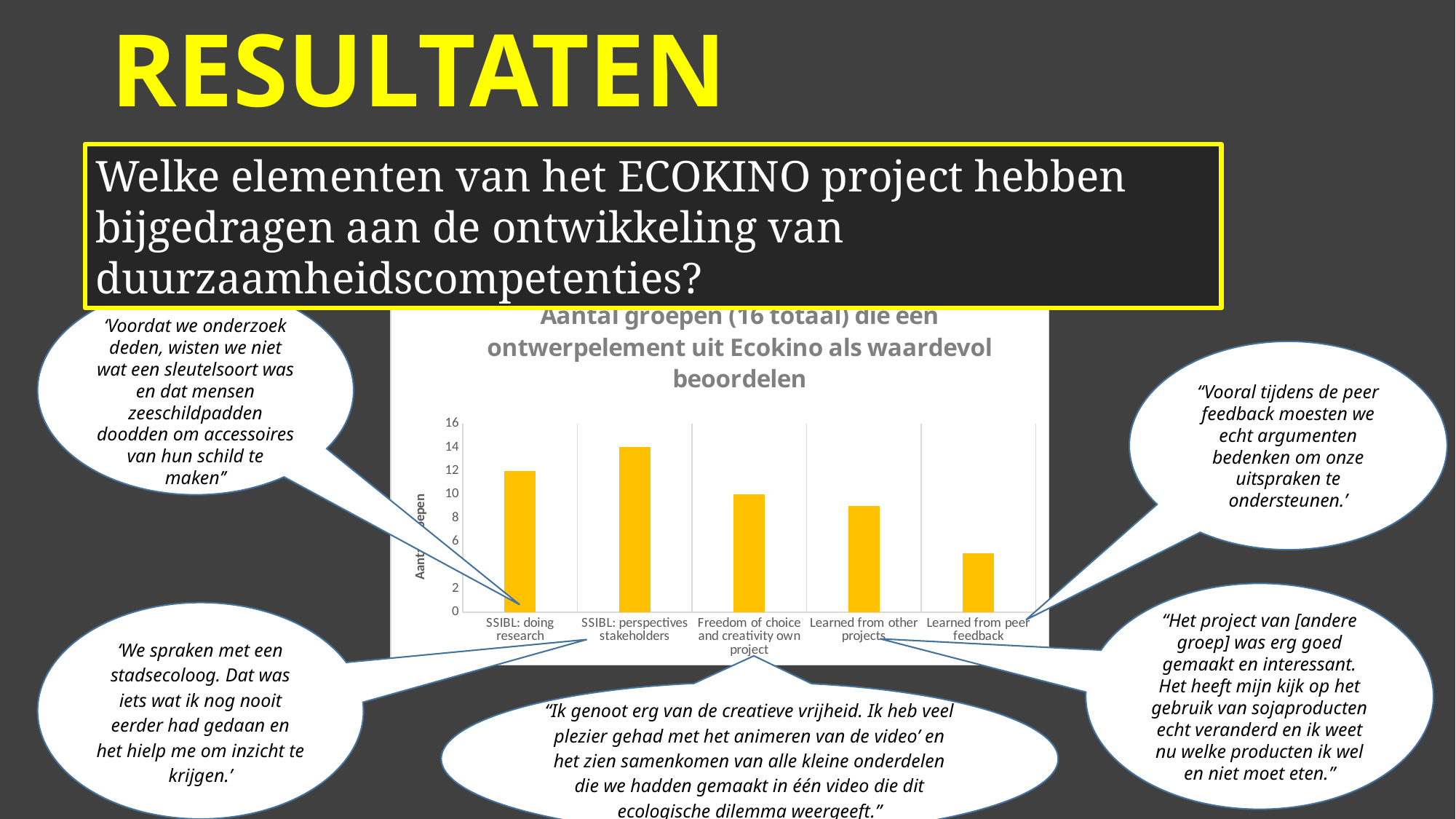
What kind of chart is shown on the slide? bar chart Which is larger: the value for SSIBL: doing research or the value for Learned from other projects? SSIBL: doing research Do the bar values generally rise or fall from left to right across the chart? fall How many categories are shown on the x axis of the chart? 5 What is the value for SSIBL: perspectives stakeholders? 14 What is the maximum value shown on the chart's vertical axis? 16 Is the value for Freedom of choice and creativity own project greater or less than 12? less Is the value for Learned from other projects greater or less than 8? greater Which category has the highest bar in the chart? SSIBL: perspectives stakeholders Is the value for SSIBL: doing research greater or less than 10? greater Which category has the lowest bar in the chart? Learned from peer feedback